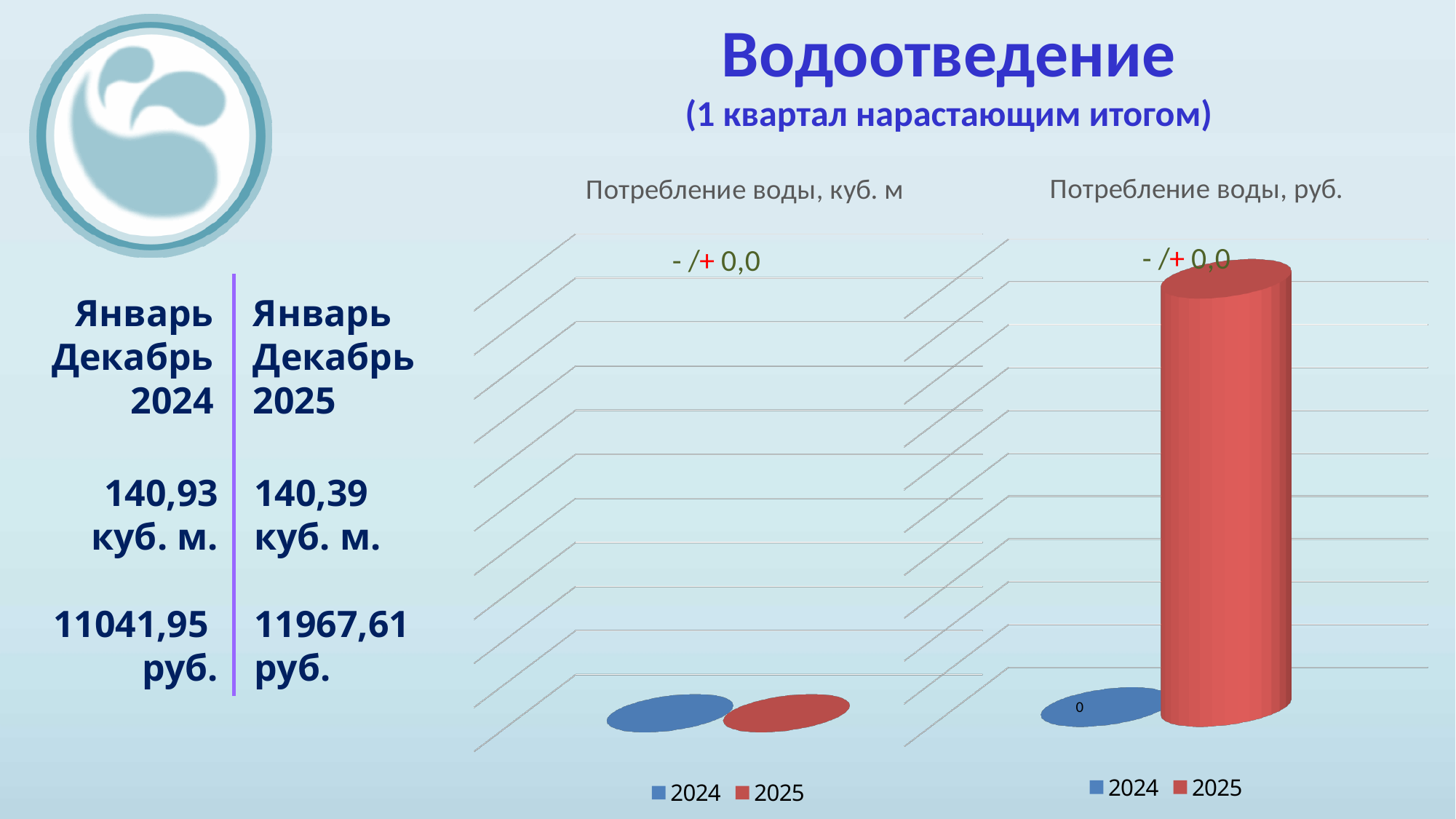
What kind of chart is the chart titled "Потребление воды, куб. м"? bar chart What is the title of the chart on the right side of the slide? Потребление воды, руб. In the chart titled "Потребление воды, руб.", which series has the tallest bar? 2025 In the chart titled "Потребление воды, руб.", what value is printed on the 2024 bar? 0 How many bars are plotted in the chart titled "Потребление воды, руб."? 2 What kind of chart is the chart titled "Потребление воды, руб."? bar chart In the chart titled "Потребление воды, руб.", which series has the lowest bar? 2024 In the chart titled "Потребление воды, руб.", which series has the larger bar, 2024 or 2025? 2025 How many series does the legend of the chart titled "Потребление воды, куб. м" list? 2 What are the legend entries of the chart titled "Потребление воды, куб. м"? 2024, 2025 How many series does the legend of the chart titled "Потребление воды, руб." list? 2